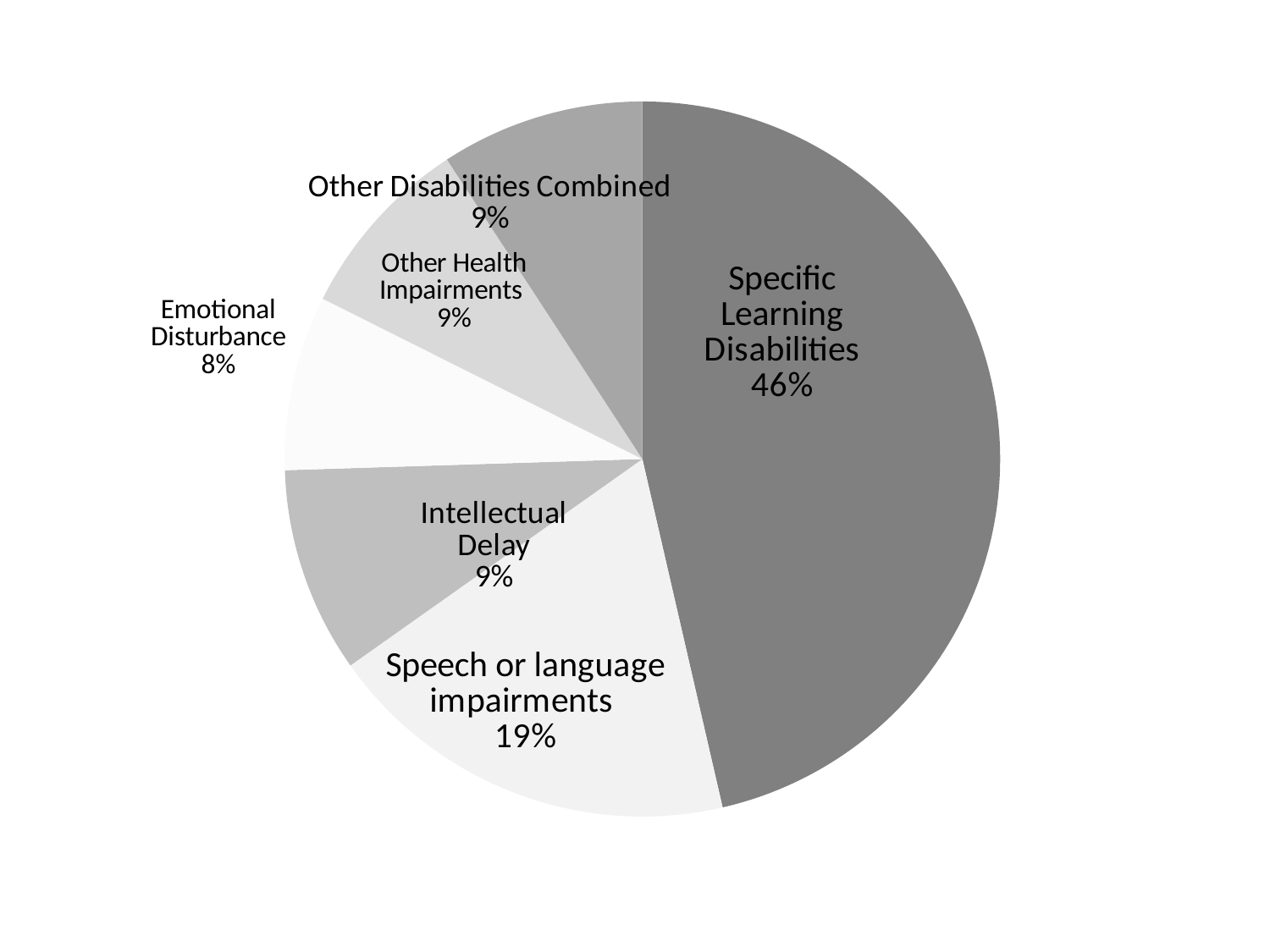
What share of the pie is Speech or language impairments? 19% What is the difference between the shares for Specific Learning Disabilities and Speech or language impairments? 27% Which is larger, the share for Speech or language impairments or the share for Intellectual Delay? Speech or language impairments What kind of chart is shown on the slide? pie chart What share of the pie is Specific Learning Disabilities? 46% What is the difference between the shares for Intellectual Delay and Emotional Disturbance? 1% Which category has the smallest slice of the pie? Emotional Disturbance What share of the pie is Emotional Disturbance? 8% Which category has the largest slice of the pie? Specific Learning Disabilities Which slice of the pie is the darkest shade of grey? Specific Learning Disabilities How many slices does the pie chart have? 6